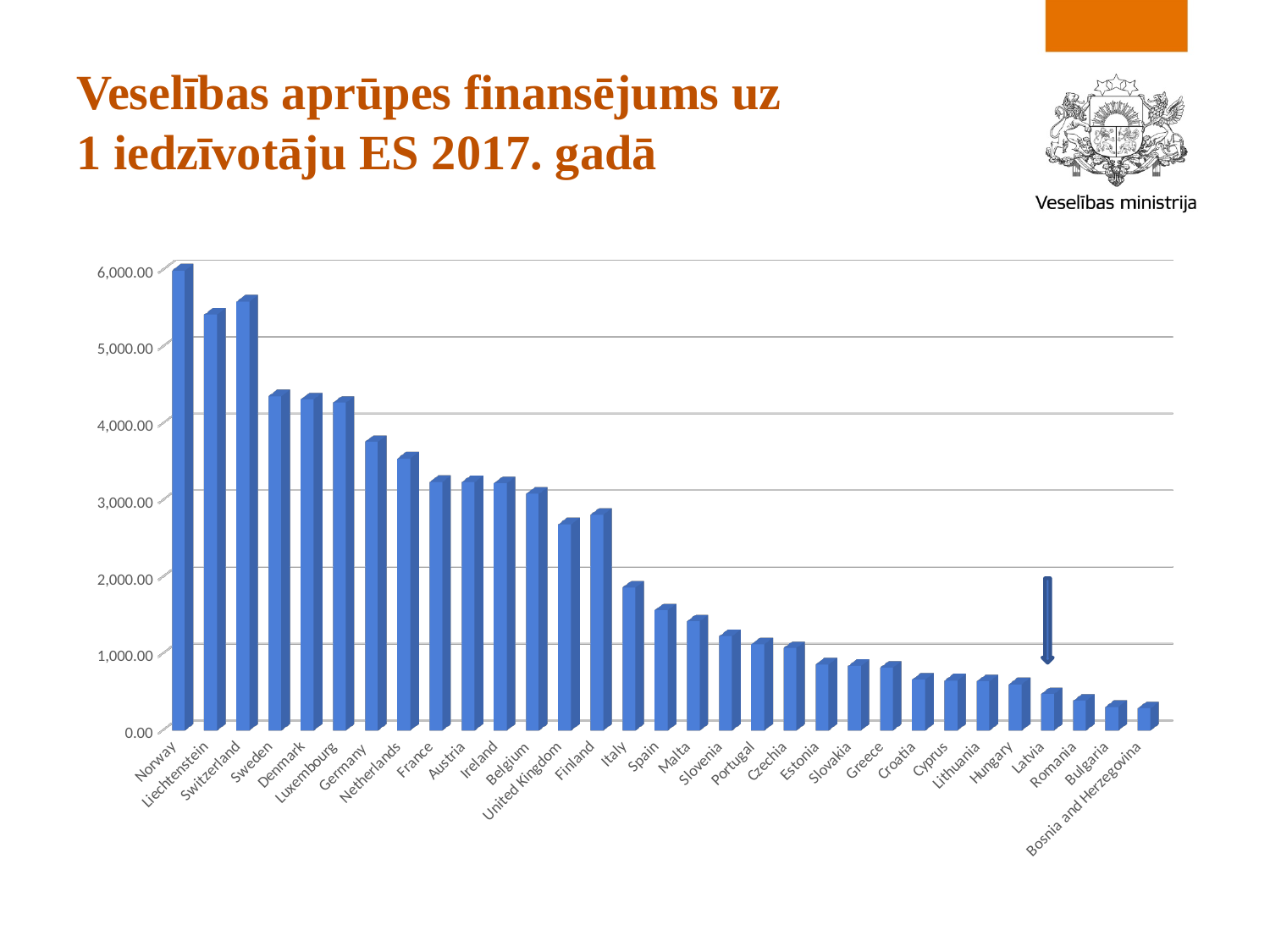
Is the value for Latvia greater or less than 1,000.00? less Is the value for Sweden greater or less than 4,000.00? greater Which has the larger value, Germany or Netherlands? Germany Is the value for Norway greater or less than 5,000.00? greater Which country has the highest value in the chart? Norway How many countries are shown on the x axis of the chart? 31 What kind of chart is shown on the slide? bar chart Do the values rise or fall moving from left to right along the x axis? fall Which has the larger value, Hungary or Latvia? Hungary Which country's bar does the arrow on the chart point to? Latvia